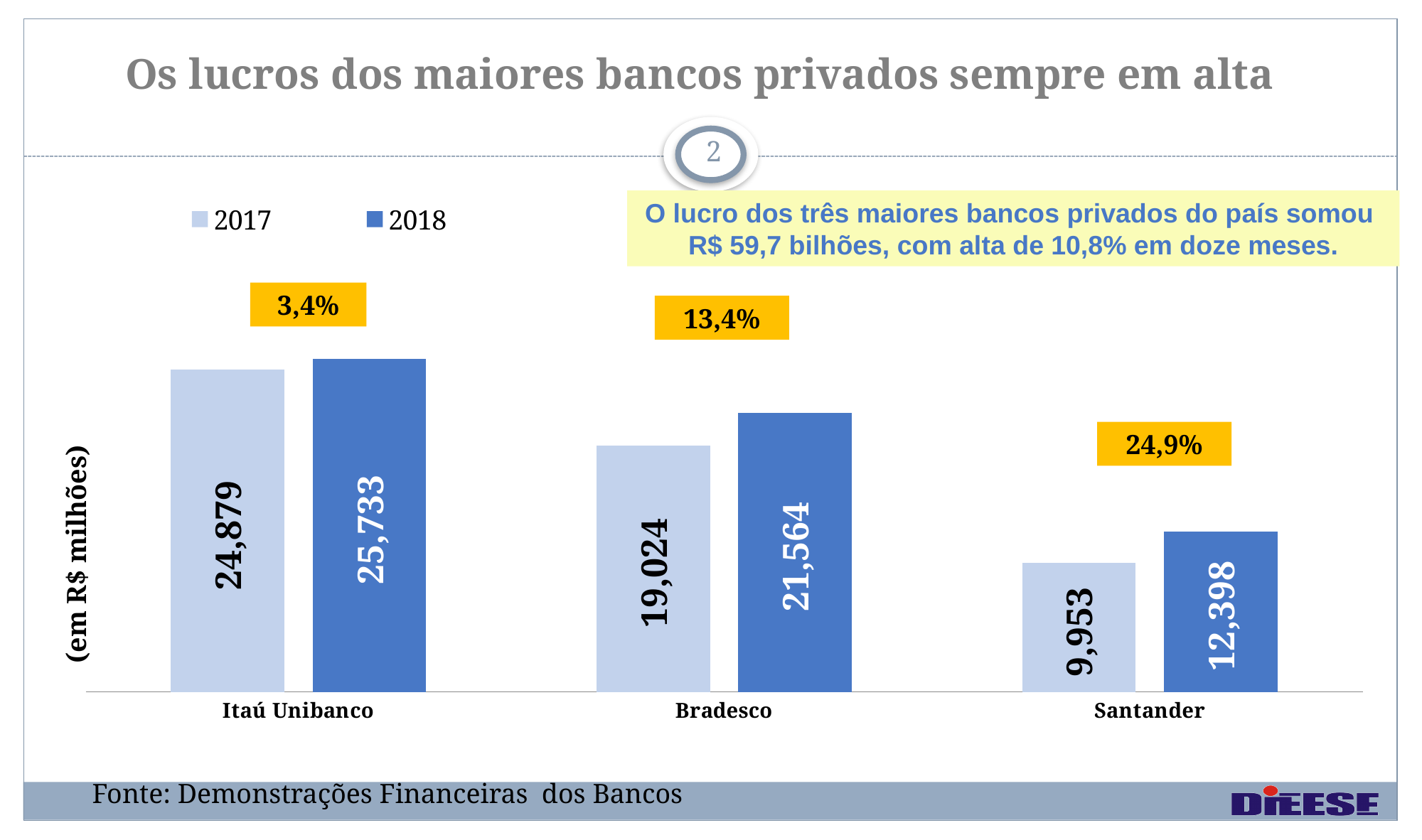
What is the 2017 value for Itaú Unibanco? 24,879 Which bank has the highest 2018 value? Itaú Unibanco What kind of chart is shown on the slide? Bar chart Which bank has the lowest 2017 value? Santander How many banks are shown on the x axis? 3 Which is larger: the 2018 value for Santander or the 2017 value for Bradesco? 2017 value for Bradesco How many series does the legend list? 2 What is the difference between the 2018 values for Itaú Unibanco and Bradesco? 4,169 What is the difference between the 2018 and 2017 values for Bradesco? 2,540 What is the 2017 value for Santander? 9,953 What percentage growth is shown above the Santander bars? 24,9% What is the 2018 value for Bradesco? 21,564